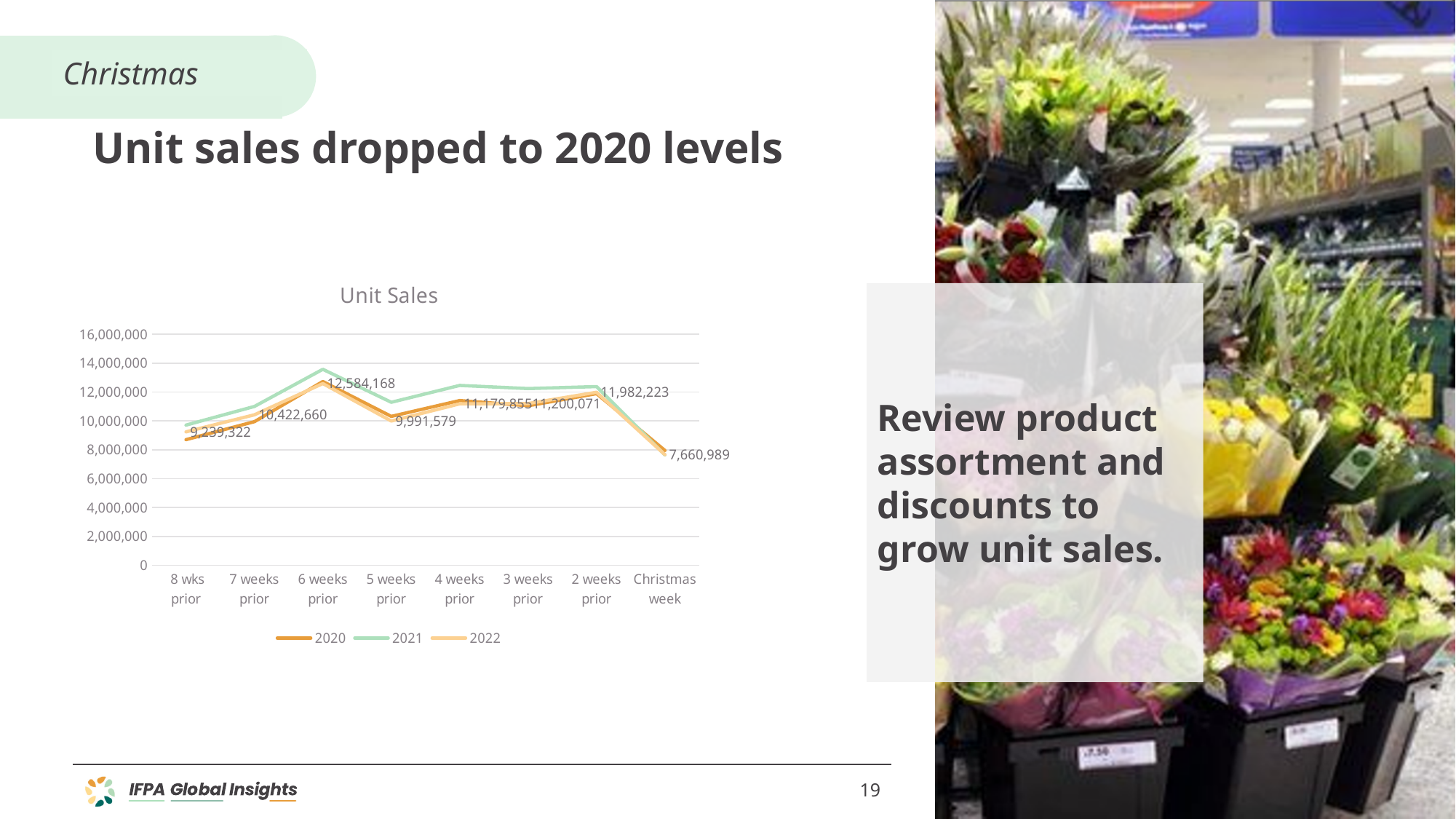
What type of chart is shown on the slide? line chart How many time periods are shown along the x axis of the chart? 8 How many series does the chart legend list? 3 What is the data label shown for 6 weeks prior? 12,584,168 What is the data label shown for 8 wks prior? 9,239,322 Among the labelled values, which period has the highest value? 6 weeks prior Among the labelled values, which period has the lowest value? Christmas week What is the title of the chart? Unit Sales What is the data label shown for Christmas week? 7,660,989 Is the 2021 value at 6 weeks prior greater or less than 12,000,000? greater What is the difference between the labelled values for 6 weeks prior and Christmas week? 4,923,179 Do the lines rise or fall from 2 weeks prior to Christmas week? fall